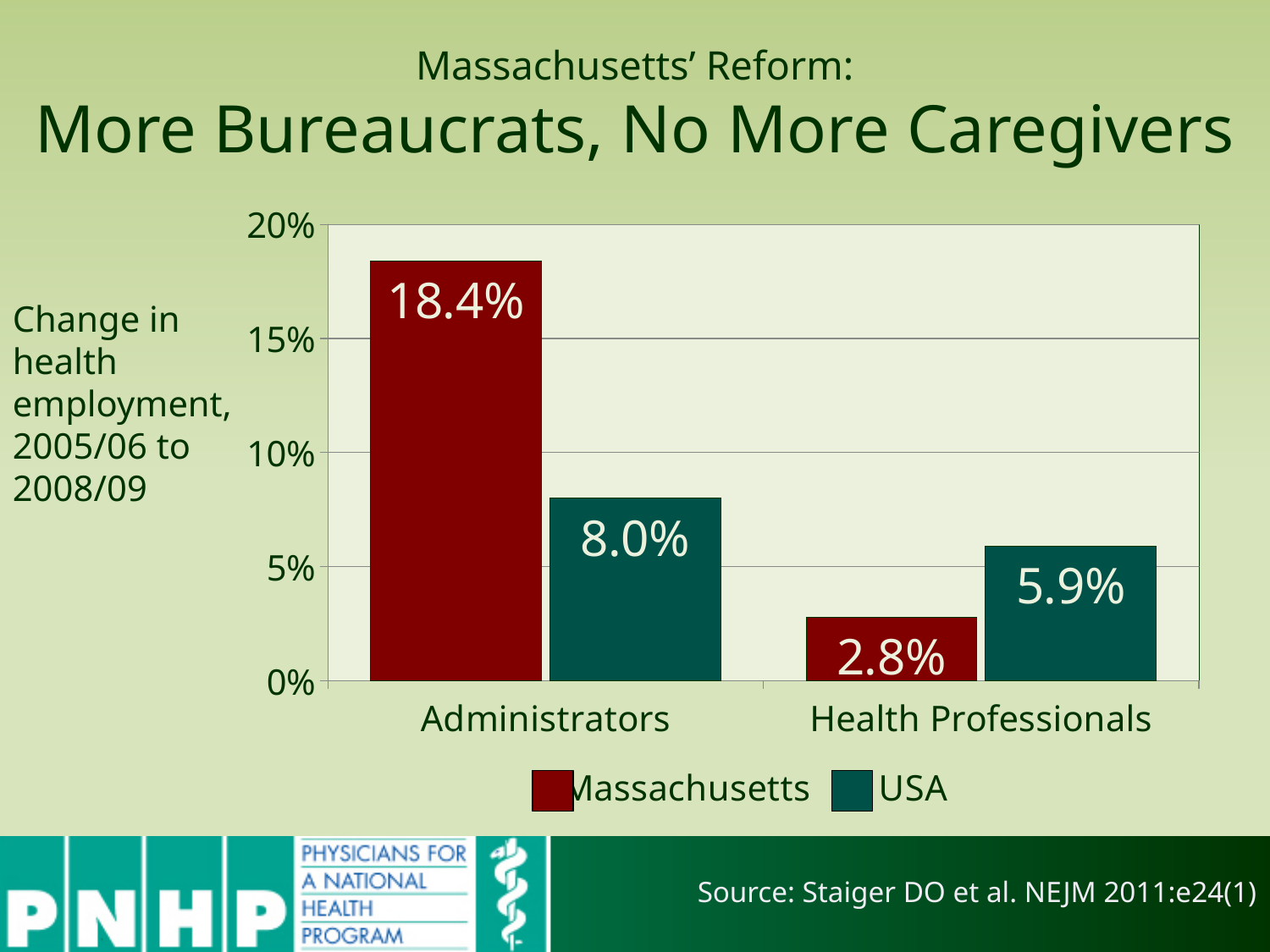
What is the difference between the Massachusetts and USA values for Administrators? 10.4% How many categories are shown on the x axis? 2 For Health Professionals, which is larger: Massachusetts or USA? USA What kind of chart is shown on the slide? Bar chart Which bar shows the lowest value on the chart? Massachusetts, Health Professionals What is the change in health employment for Administrators in the USA? 8.0% How many series does the legend list? 2 What is the change in health employment for Administrators in Massachusetts? 18.4% What is the change in health employment for Health Professionals in the USA? 5.9% Which bar shows the highest value on the chart? Massachusetts, Administrators What is the difference between the USA and Massachusetts values for Health Professionals? 3.1% What is the change in health employment for Health Professionals in Massachusetts? 2.8%